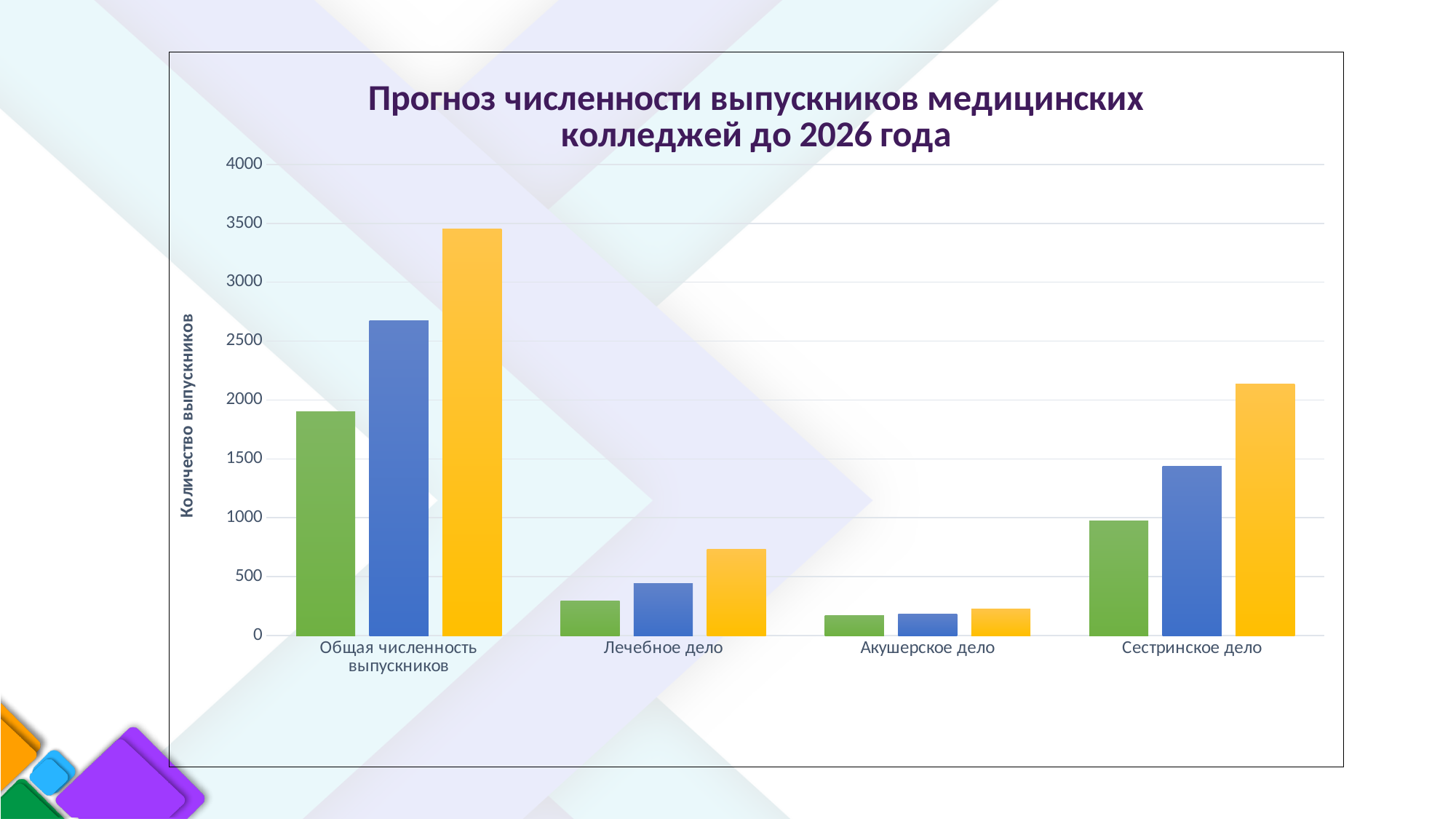
Is the value of the yellow bar for Общая численность выпускников greater or less than 3000? greater What is the title of the chart? Прогноз численности выпускников медицинских колледжей до 2026 года Which category has the shortest bars in the chart? Акушерское дело Which is larger: the blue bar for Акушерское дело or the green bar for Сестринское дело? green bar for Сестринское дело What kind of chart is shown on the slide? bar chart Is the value of the blue bar for Лечебное дело greater or less than 500? less Is the value of the green bar for Общая численность выпускников greater or less than 2000? less What is the label of the vertical axis? Количество выпускников Which is larger: the yellow bar for Лечебное дело or the yellow bar for Сестринское дело? Сестринское дело How many categories are shown on the x axis of the chart? 4 Which category has the tallest bar in the chart? Общая численность выпускников